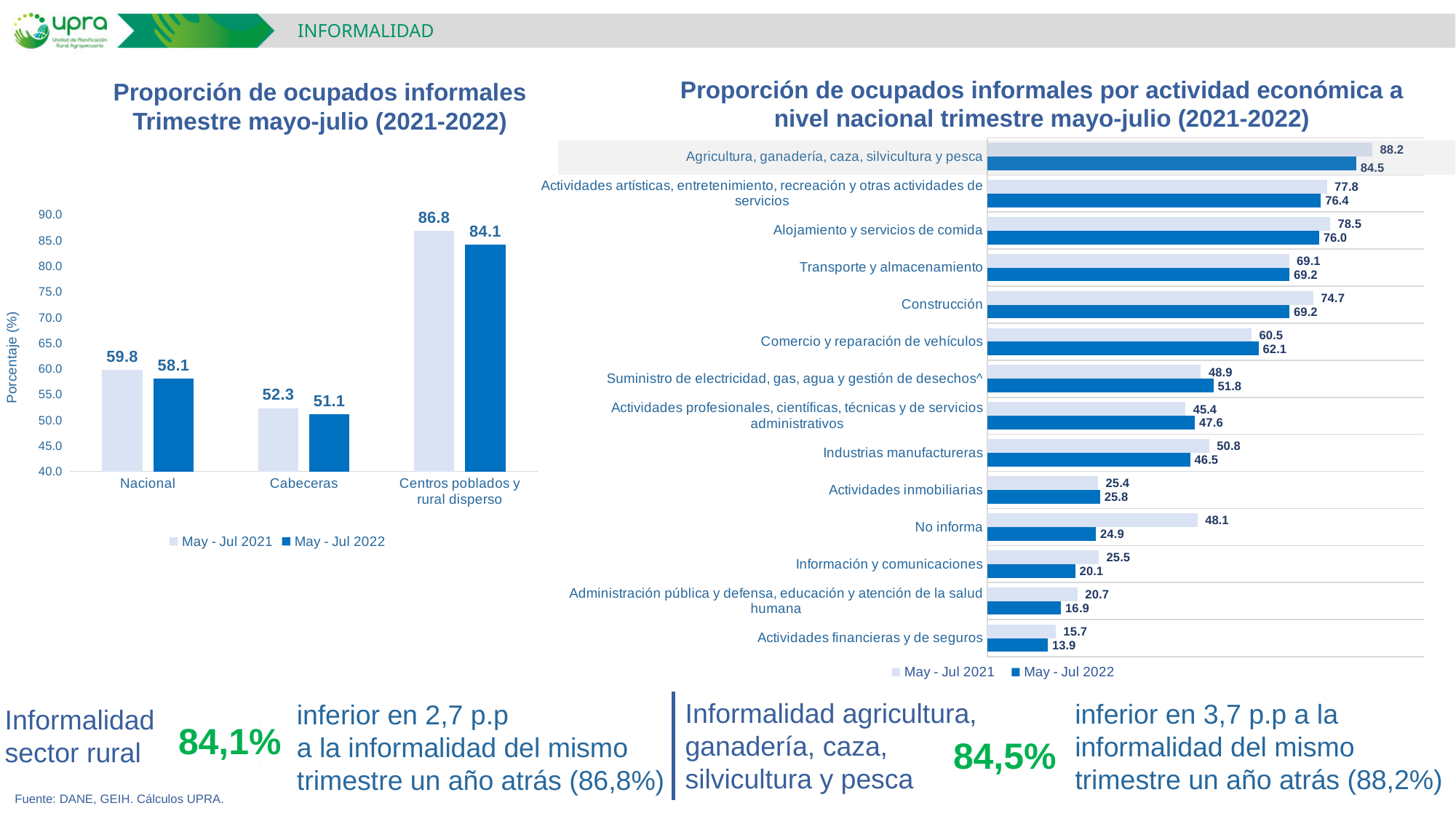
In the left chart 'Proporción de ocupados informales Trimestre mayo-julio (2021-2022)', how many categories are shown on the x axis? 3 In the right chart 'Proporción de ocupados informales por actividad económica', how many series does the legend list? 2 In the right chart 'Proporción de ocupados informales por actividad económica', what is the May - Jul 2022 value for Agricultura, ganadería, caza, silvicultura y pesca? 84.5 In the right chart 'Proporción de ocupados informales por actividad económica', what is the May - Jul 2021 value for Transporte y almacenamiento? 69.1 In the left chart 'Proporción de ocupados informales Trimestre mayo-julio (2021-2022)', what is the value for Nacional in May - Jul 2022? 58.1 In the left chart 'Proporción de ocupados informales Trimestre mayo-julio (2021-2022)', what is the difference between the May - Jul 2021 and May - Jul 2022 values for Centros poblados y rural disperso? 2.7 In the right chart 'Proporción de ocupados informales por actividad económica', which is larger for Construcción: the May - Jul 2021 value or the May - Jul 2022 value? May - Jul 2021 In the right chart 'Proporción de ocupados informales por actividad económica', how many economic activities are listed? 14 In the left chart 'Proporción de ocupados informales Trimestre mayo-julio (2021-2022)', which category has the highest value for May - Jul 2021? Centros poblados y rural disperso In the right chart 'Proporción de ocupados informales por actividad económica', what is the difference between the May - Jul 2021 and May - Jul 2022 values for No informa? 23.2 In the right chart 'Proporción de ocupados informales por actividad económica', which activity has the lowest value for May - Jul 2022? Actividades financieras y de seguros In the left chart 'Proporción de ocupados informales Trimestre mayo-julio (2021-2022)', what kind of chart is it? Bar chart